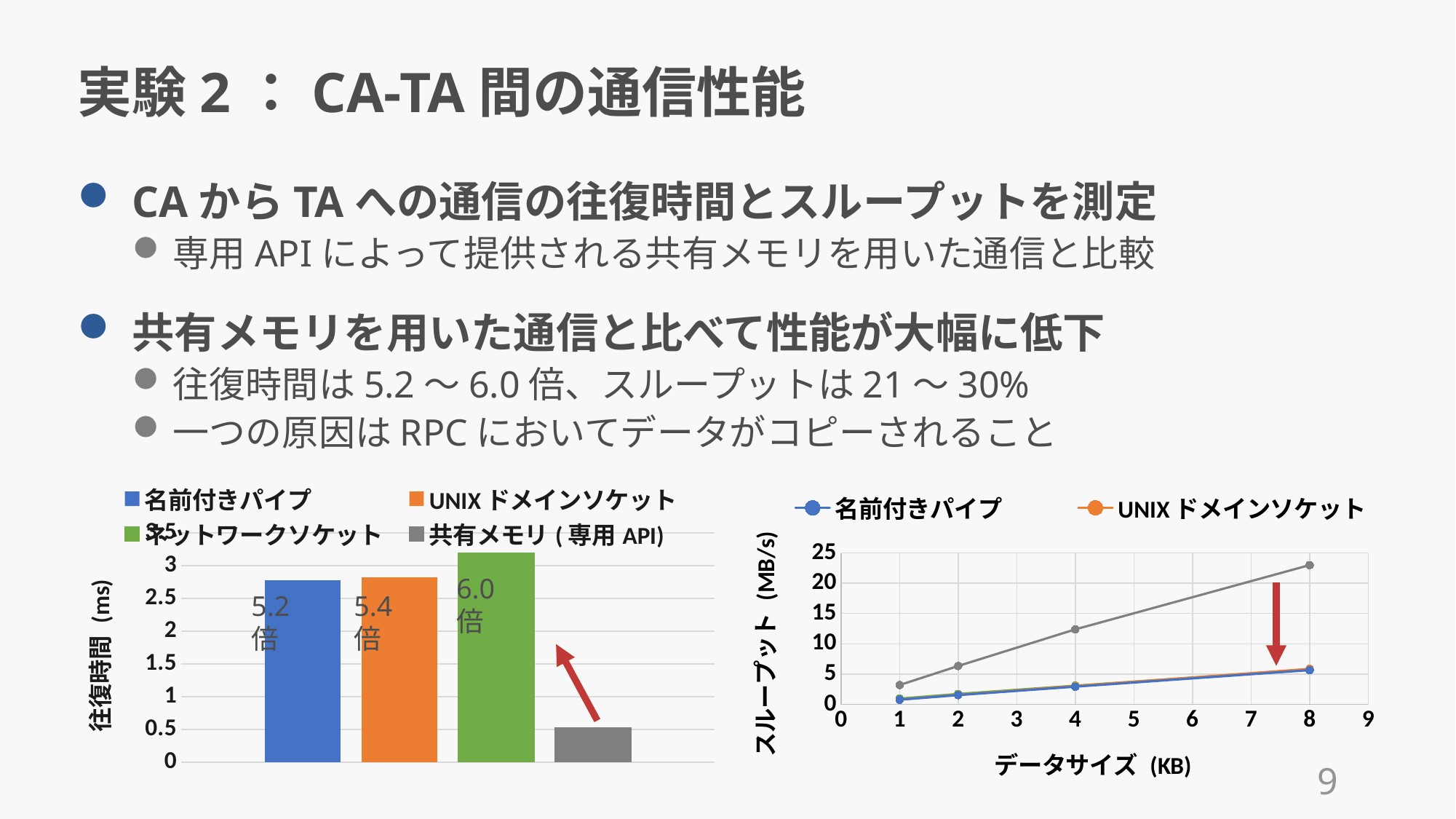
In the left chart (往復時間), how many bars are plotted? 4 How many series does the legend of the right chart (スループット) list? 2 What is the x-axis label of the right chart (スループット)? データサイズ (KB) In the left chart (往復時間), which category has the lowest round-trip time? 共有メモリ ( 専用 API) What kind of chart is the left chart (往復時間)? bar chart In the left chart (往復時間), is the value for ネットワークソケット greater or less than 3? greater What kind of chart is the right chart (スループット)? line chart In the right chart (スループット), does the throughput for 名前付きパイプ rise or fall as data size increases? rise In the left chart (往復時間), is the value for 共有メモリ ( 専用 API) greater or less than 1? less In the right chart (スループット), is the value for UNIX ドメインソケット at 8 KB greater or less than 10? less In the left chart (往復時間), which category has the highest round-trip time? ネットワークソケット